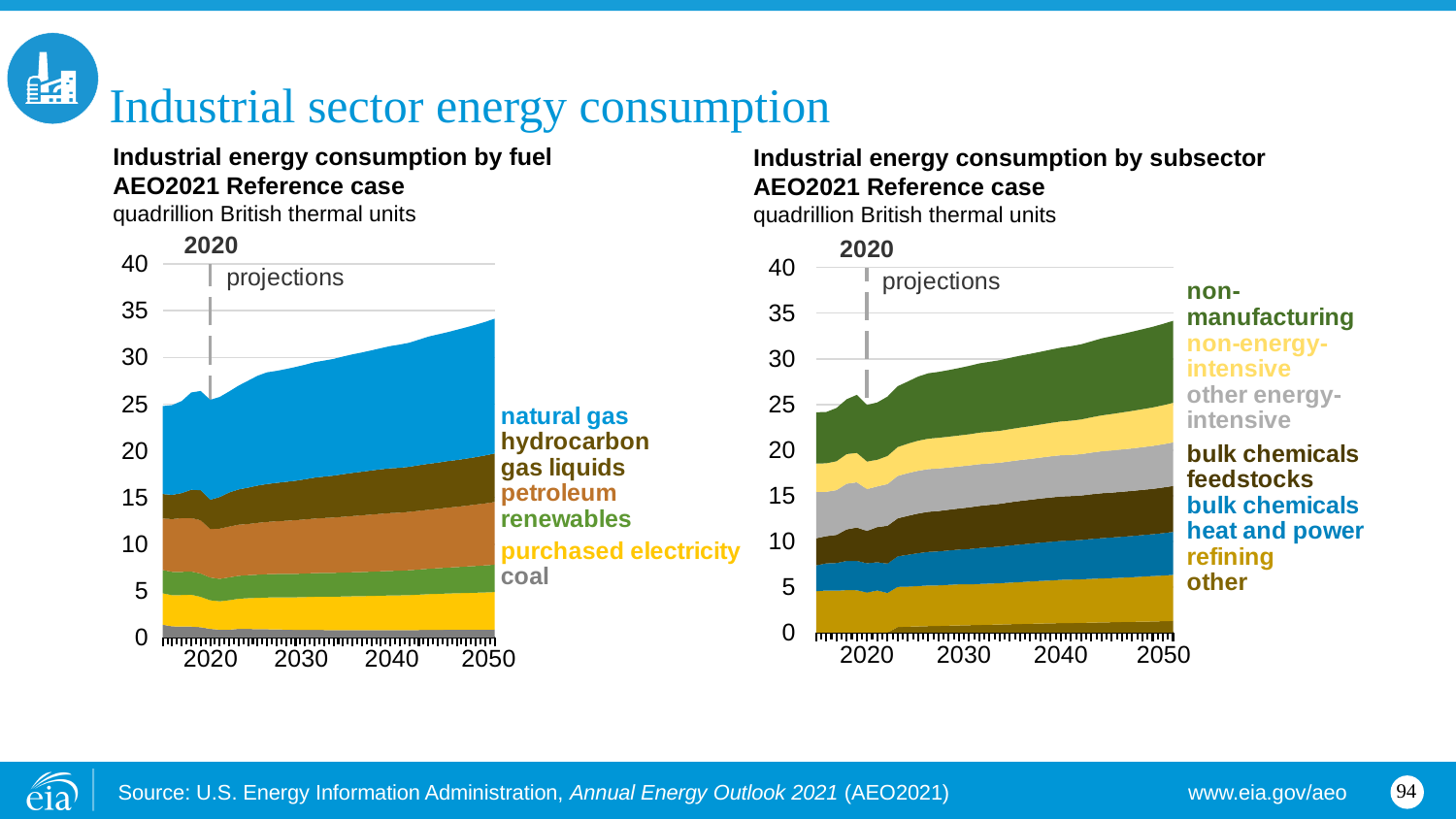
In the right chart, 'Industrial energy consumption by subsector', which subsector accounts for the largest share of consumption in 2050? non-manufacturing In which year do the projections begin in both charts, as marked by the dashed vertical line? 2020 How many subsector series are listed in the legend of the right chart, 'Industrial energy consumption by subsector'? 7 In the left chart, 'Industrial energy consumption by fuel', does total industrial energy consumption rise or fall between 2020 and 2050? rise In the left chart, 'Industrial energy consumption by fuel', which fuel accounts for the smallest share of consumption in 2050? coal How many fuel series are listed in the legend of the left chart, 'Industrial energy consumption by fuel'? 6 In the left chart, 'Industrial energy consumption by fuel', which fuel accounts for the largest share of consumption in 2050? natural gas In the left chart, 'Industrial energy consumption by fuel', is total industrial energy consumption in 2050 greater or less than 30 quadrillion Btu? greater What type of chart is the 'Industrial energy consumption by fuel' chart on the left? stacked area chart In the right chart, 'Industrial energy consumption by subsector', is total industrial energy consumption in 2050 greater or less than 30 quadrillion Btu? greater In the right chart, 'Industrial energy consumption by subsector', which subsector accounts for the smallest share of consumption in 2050? other What unit of measurement is used on the y axis of both charts? quadrillion British thermal units